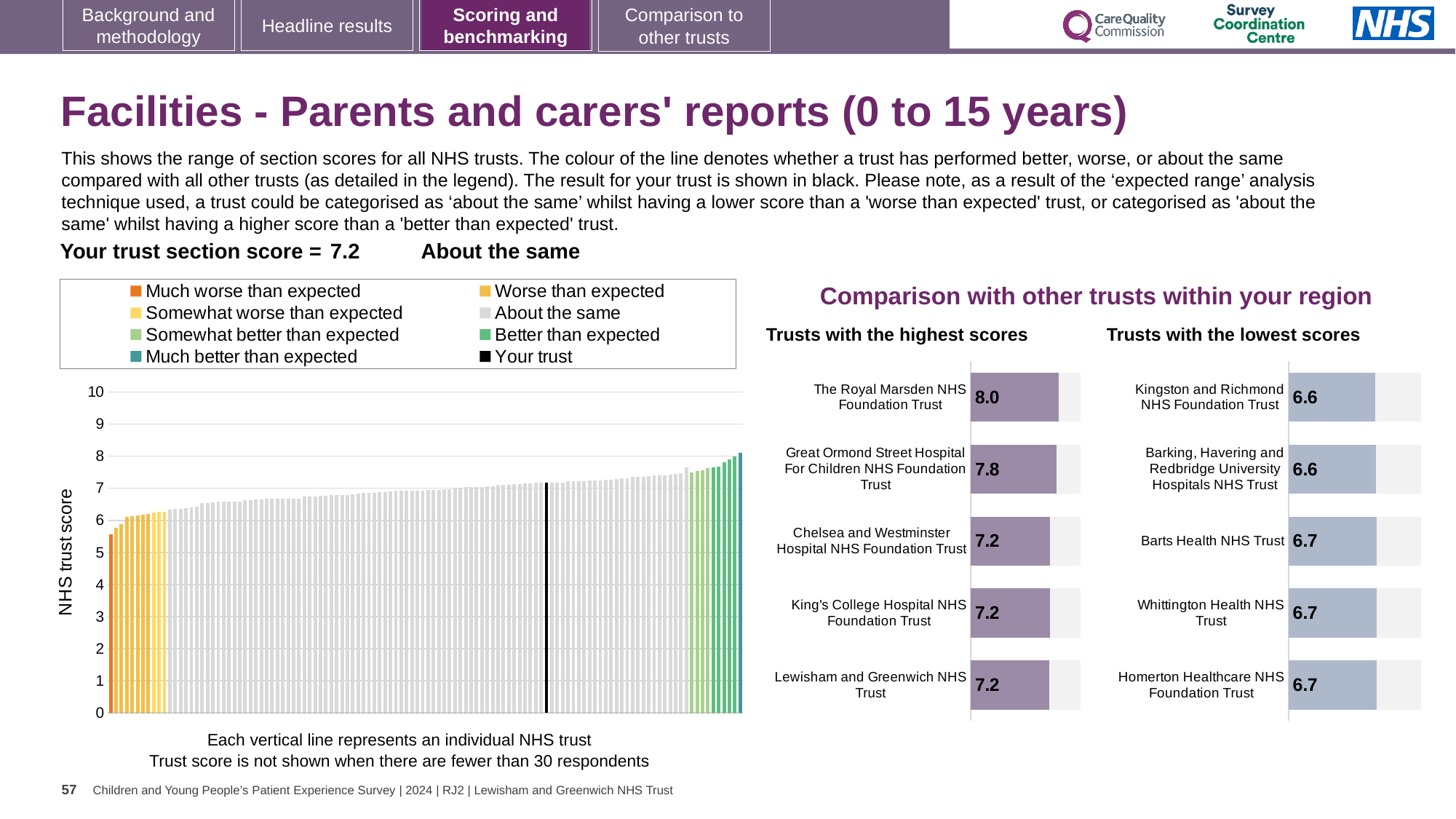
In the 'Trusts with the highest scores' chart, what is the score for The Royal Marsden NHS Foundation Trust? 8.0 In the 'Trusts with the highest scores' chart, what is the score for Great Ormond Street Hospital For Children NHS Foundation Trust? 7.8 In the 'Trusts with the highest scores' chart, which trust has the highest score? The Royal Marsden NHS Foundation Trust In the large chart on the left showing all NHS trusts, what kind of chart is it? Bar chart In the 'Trusts with the highest scores' chart, what is the difference between the scores of The Royal Marsden NHS Foundation Trust and Great Ormond Street Hospital For Children NHS Foundation Trust? 0.2 In the 'Trusts with the lowest scores' chart, how many trusts are shown? 5 Comparing the two regional charts, which has the larger score: Great Ormond Street Hospital For Children NHS Foundation Trust or Barts Health NHS Trust? Great Ormond Street Hospital For Children NHS Foundation Trust In the 'Trusts with the lowest scores' chart, what is the score for Kingston and Richmond NHS Foundation Trust? 6.6 What is the difference between the score of The Royal Marsden NHS Foundation Trust in the highest scores chart and Kingston and Richmond NHS Foundation Trust in the lowest scores chart? 1.4 In the large chart on the left showing all NHS trusts, do the trust scores rise or fall from left to right? Rise In the 'Trusts with the highest scores' chart, how many trusts are shown? 5 In the 'Trusts with the lowest scores' chart, what is the score for Barts Health NHS Trust? 6.7